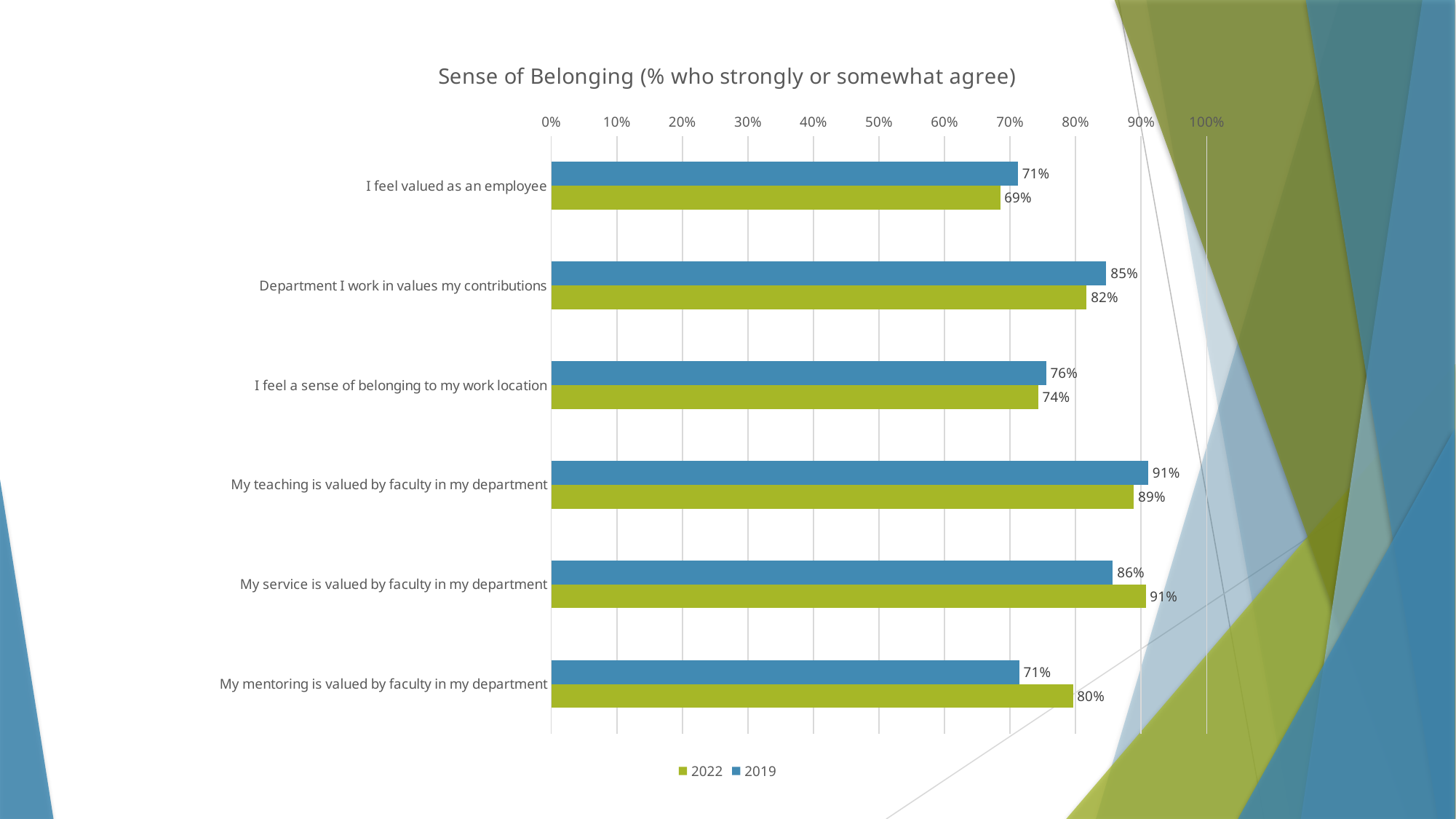
Which category has the highest 2019 value? My teaching is valued by faculty in my department How many categories are shown on the chart? 6 What is the 2022 value for "I feel a sense of belonging to my work location"? 74% What is the title of the chart? Sense of Belonging (% who strongly or somewhat agree) What is the difference between the 2022 and 2019 values for "My mentoring is valued by faculty in my department"? 9% How many series does the legend list? 2 For "My service is valued by faculty in my department", which year has the larger value, 2022 or 2019? 2022 Which category has the lowest 2022 value? I feel valued as an employee What is the 2022 value for "My mentoring is valued by faculty in my department"? 80% Which category has the highest 2022 value? My service is valued by faculty in my department What kind of chart is shown on the slide? Bar chart What is the 2019 value for "Department I work in values my contributions"? 85%